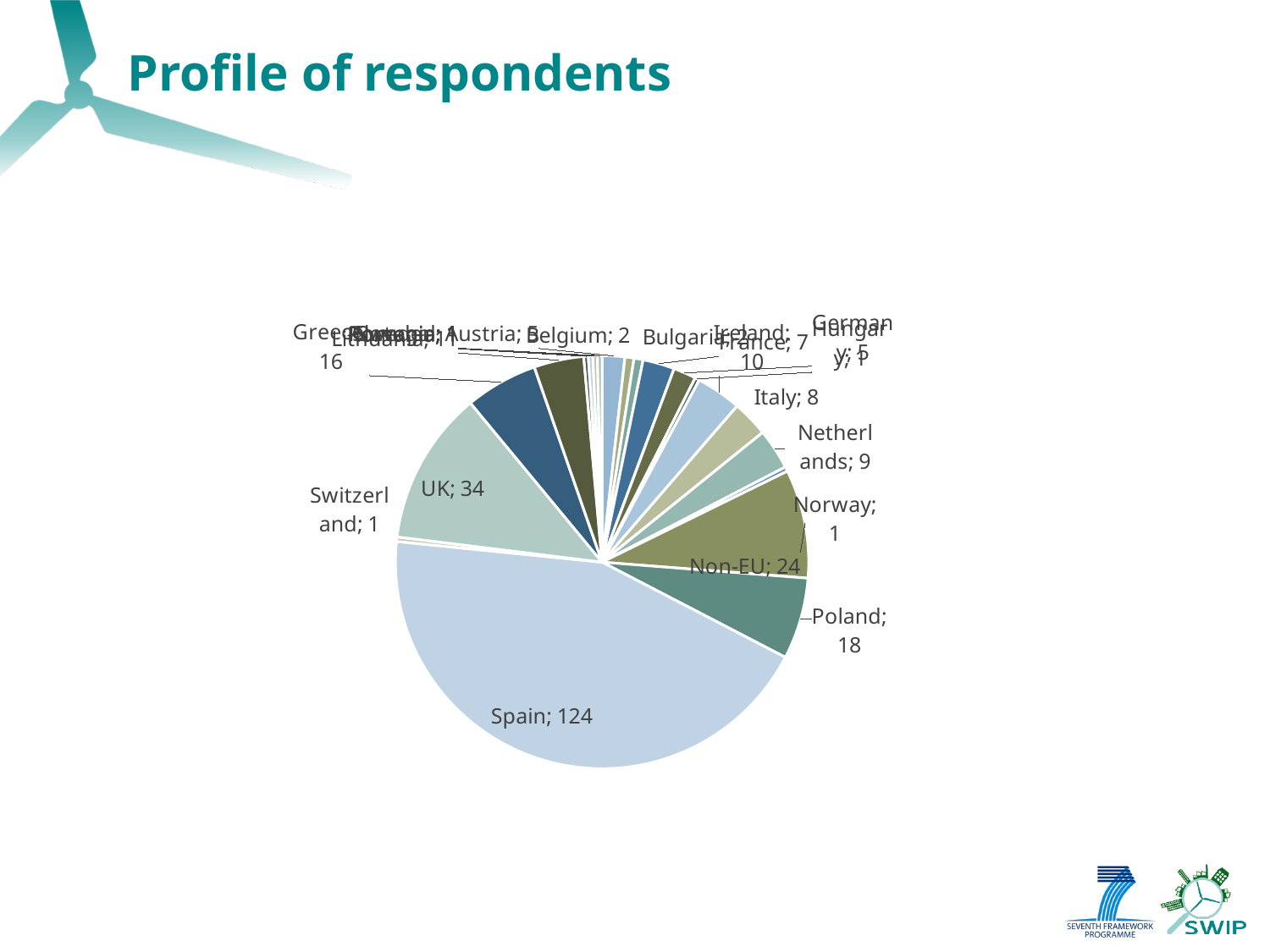
What is the value shown for Ireland? 10 What is the value shown for the UK slice? 34 What kind of chart is shown on the slide? pie chart How many respondents are from Spain? 124 What is the difference between the values for Spain and the UK? 90 What is the value shown for Poland? 18 Which country has the largest slice of the pie? Spain Which is larger, the value for Poland or the value for the Netherlands? Poland What is the value shown for the Netherlands? 9 What is the value shown for Italy? 8 What is the title of the slide containing the chart? Profile of respondents What is the value shown for Non-EU? 24